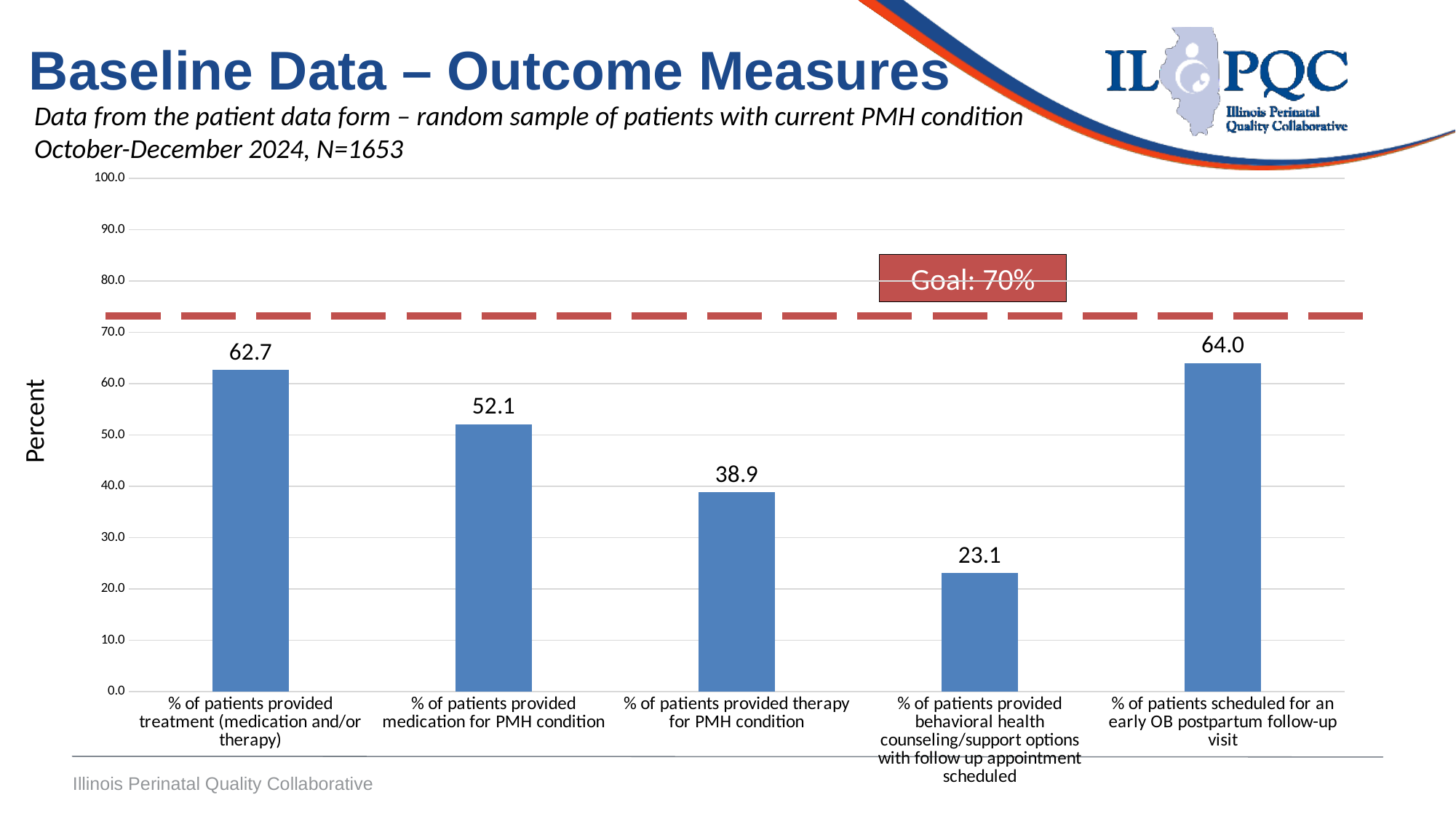
What kind of chart is shown on the slide? Bar chart What goal percentage is marked by the dashed line on the chart? 70% What is the value for % of patients provided behavioral health counseling/support options with follow up appointment scheduled? 23.1 How many categories are shown in the chart? 5 Which category has the highest value? % of patients scheduled for an early OB postpartum follow-up visit What is the value for % of patients provided medication for PMH condition? 52.1 Which category has the lowest value? % of patients provided behavioral health counseling/support options with follow up appointment scheduled Which is larger: the value for % of patients provided treatment (medication and/or therapy) or the value for % of patients scheduled for an early OB postpartum follow-up visit? % of patients scheduled for an early OB postpartum follow-up visit What is the value for % of patients provided therapy for PMH condition? 38.9 What is the difference between the value for % of patients provided medication for PMH condition and the value for % of patients provided therapy for PMH condition? 13.2 What is the value for % of patients scheduled for an early OB postpartum follow-up visit? 64.0 What is the value for % of patients provided treatment (medication and/or therapy)? 62.7